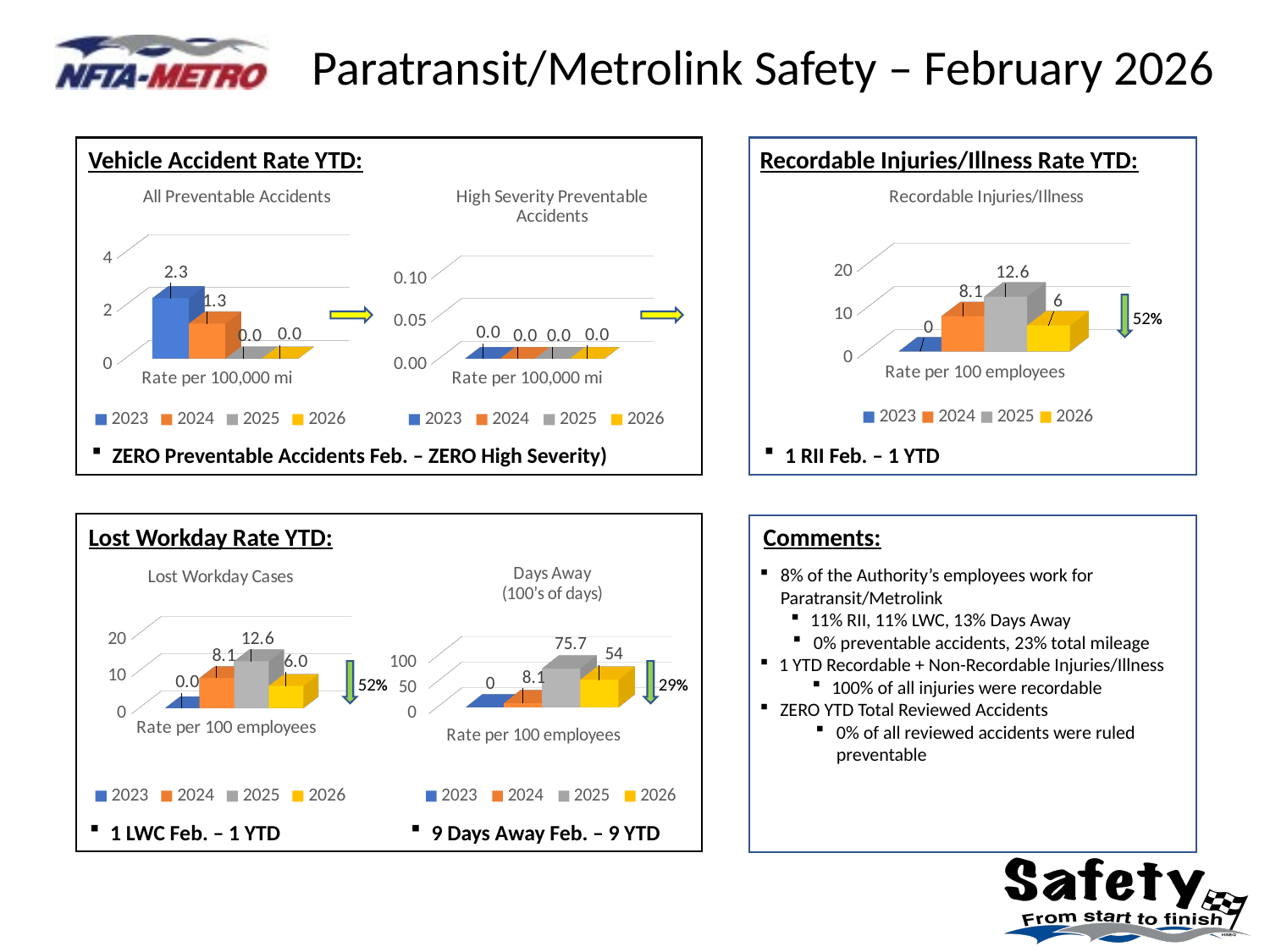
In the Recordable Injuries/Illness chart, which year has the highest value? 2025 In the Days Away chart, what is the value for 2025? 75.7 In the Recordable Injuries/Illness chart, what is the value for 2026? 6 In the All Preventable Accidents chart, what is the value for 2023? 2.3 In the Lost Workday Cases chart, what is the value for 2025? 12.6 In the Lost Workday Cases chart, which is larger, the value for 2024 or the value for 2026? 2024 In the All Preventable Accidents chart, what is the difference between the 2023 and 2024 values? 1.0 In the All Preventable Accidents chart, what is the value for 2024? 1.3 In the High Severity Preventable Accidents chart, what is the value for 2026? 0.0 How many series does the legend of the Days Away chart list? 4 In the Recordable Injuries/Illness chart, is the value for 2025 greater or less than 10? greater In the Days Away chart, what is the difference between the 2025 and 2026 values? 21.7